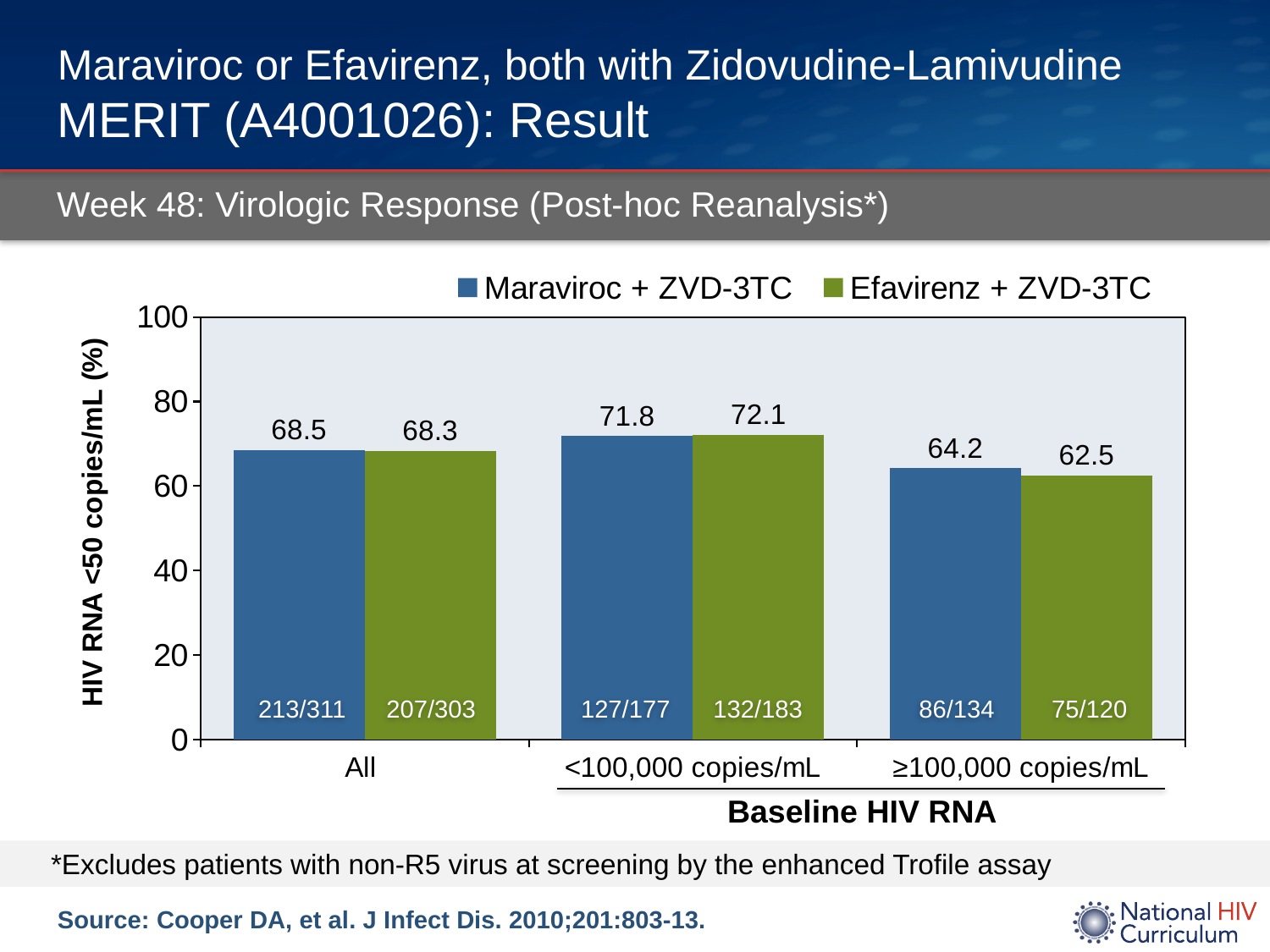
What is the value for Maraviroc + ZVD-3TC in the All category? 68.5 What kind of chart is shown on the slide? bar chart How many series does the legend list? 2 What is the value for Efavirenz + ZVD-3TC in the ≥100,000 copies/mL category? 62.5 Which series has the larger value in the <100,000 copies/mL category? Efavirenz + ZVD-3TC How many categories are shown on the x axis? 3 What is the value for Efavirenz + ZVD-3TC in the <100,000 copies/mL category? 72.1 What fraction is printed inside the Maraviroc + ZVD-3TC bar for the ≥100,000 copies/mL category? 86/134 What is the difference between the Maraviroc + ZVD-3TC and Efavirenz + ZVD-3TC values in the ≥100,000 copies/mL category? 1.7 Which category has the highest value for Maraviroc + ZVD-3TC? <100,000 copies/mL Which category has the lowest value for Efavirenz + ZVD-3TC? ≥100,000 copies/mL Is the value for Maraviroc + ZVD-3TC in the ≥100,000 copies/mL category greater or less than 80? less